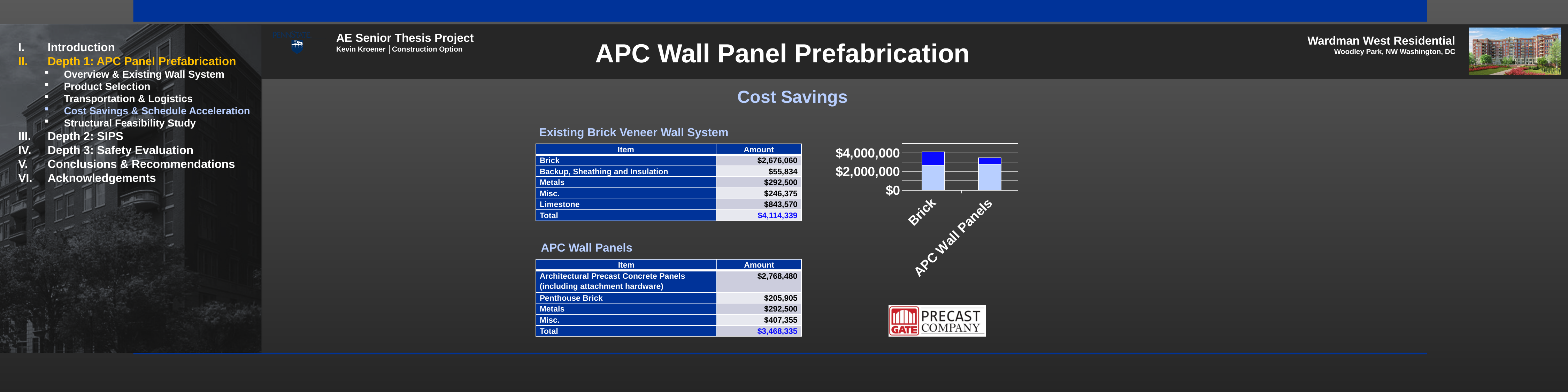
Is the value for APC Wall Panels in the chart greater or less than $2,000,000? greater Which category has the shortest bar in the chart? APC Wall Panels Is the value for Brick in the chart greater or less than $2,000,000? greater What kind of chart is shown on the slide? bar chart Which category has the tallest bar in the chart? Brick Is the value for APC Wall Panels in the chart greater or less than $4,000,000? less Which bar is taller in the chart, Brick or APC Wall Panels? Brick What is the highest tick value shown on the chart's y axis? $4,000,000 How many categories are plotted on the x axis of the chart? 2 What are the two category labels on the x axis of the chart? Brick and APC Wall Panels Do the bar values rise or fall moving from Brick to APC Wall Panels along the x axis? fall